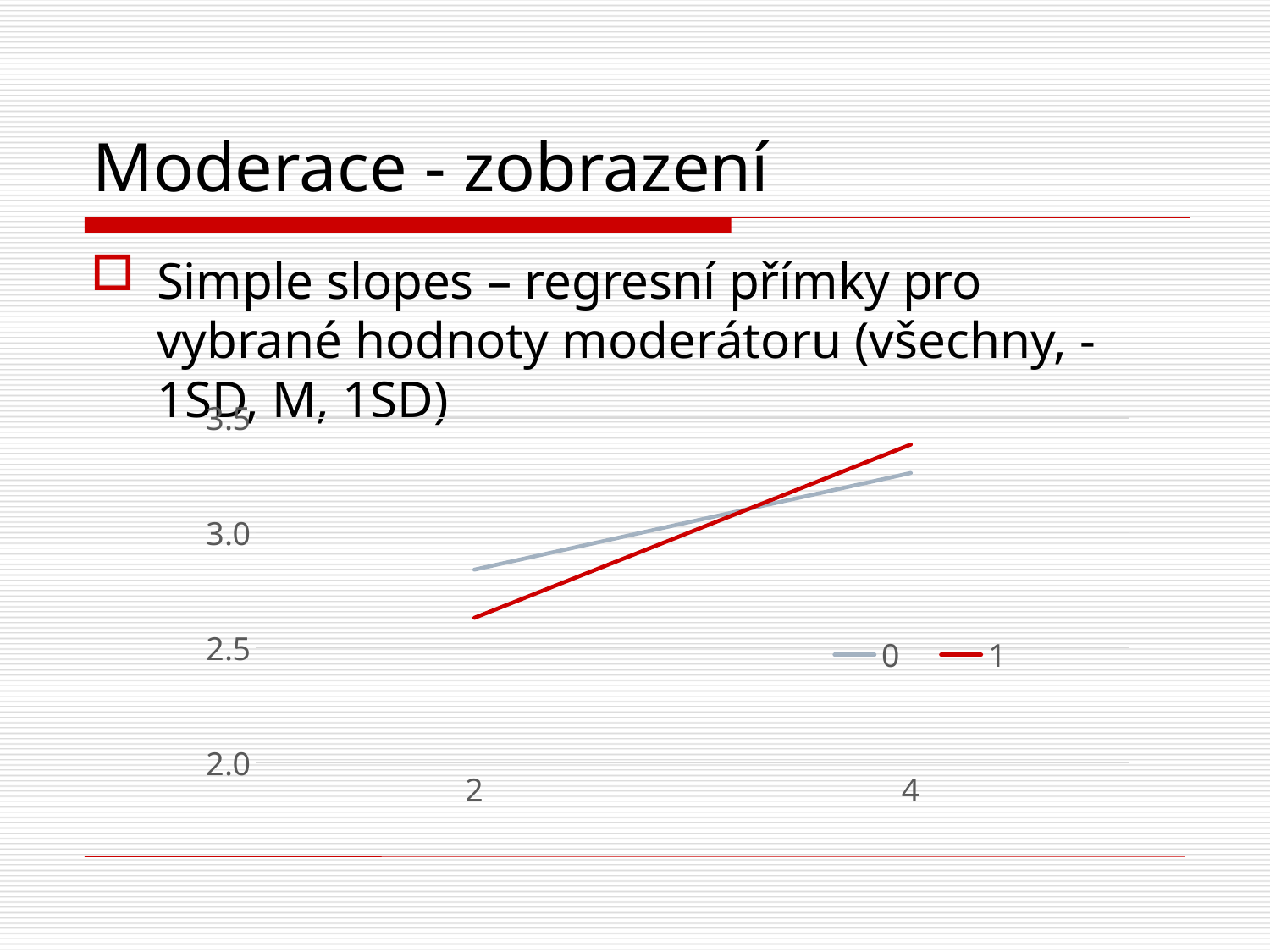
What kind of chart is shown on the slide? line chart Do the values of series 0 rise or fall from x = 2 to x = 4? rise Is the value of series 1 at x = 2 greater or less than 3.0? less At x = 2, which series has the higher value, 0 or 1? 0 How many series does the chart legend list? 2 How many x-axis categories are shown on the chart? 2 Which series is drawn in red? 1 Is the value of series 0 at x = 4 greater or less than 3.0? greater Is the value of series 1 at x = 4 greater or less than 3.0? greater At x = 4, which series has the higher value, 0 or 1? 1 What are the names of the two series in the legend? 0 and 1 Do the values of series 1 rise or fall from x = 2 to x = 4? rise